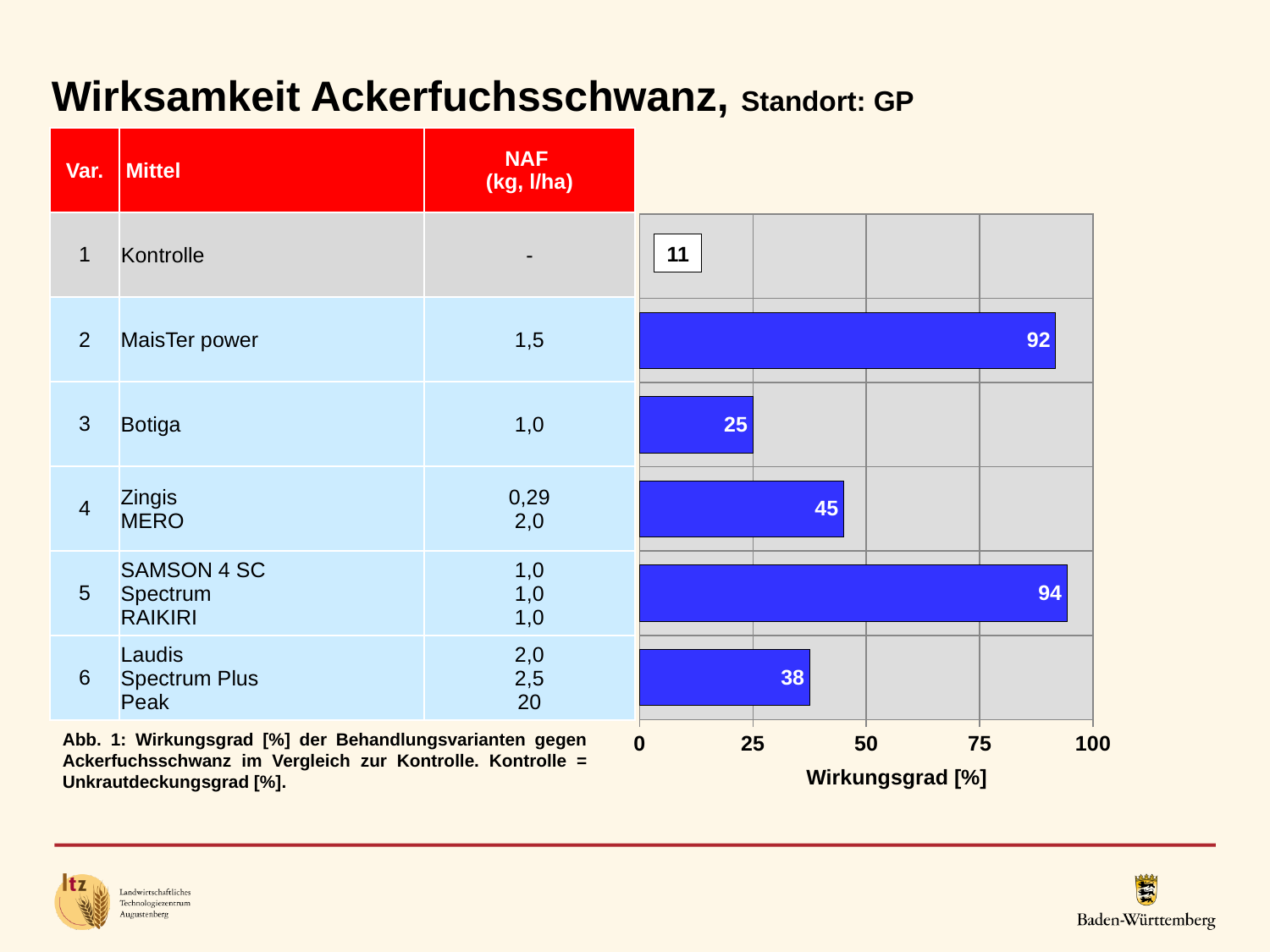
What value is shown for the Laudis + Spectrum Plus + Peak variant (Var. 6)? 38 Among the treated variants (Var. 2 to 6), which has the lowest Wirkungsgrad? Botiga (Var. 3) What is the Wirkungsgrad value for the Zingis + MERO variant (Var. 4)? 45 Is the Wirkungsgrad for Botiga greater or less than 50? less What is the Wirkungsgrad value for Botiga (Var. 3)? 25 Which has a higher Wirkungsgrad, Zingis + MERO (Var. 4) or Laudis + Spectrum Plus + Peak (Var. 6)? Zingis + MERO (Var. 4) What type of chart is used to show the Wirkungsgrad values? Bar chart What value is shown for the Kontrolle (Var. 1)? 11 Which variant has the highest Wirkungsgrad? SAMSON 4 SC + Spectrum + RAIKIRI (Var. 5) What is the Wirkungsgrad value for MaisTer power (Var. 2)? 92 What is the difference in Wirkungsgrad between Var. 5 (SAMSON 4 SC + Spectrum + RAIKIRI) and Var. 2 (MaisTer power)? 2 What is the label of the horizontal axis of the chart? Wirkungsgrad [%]